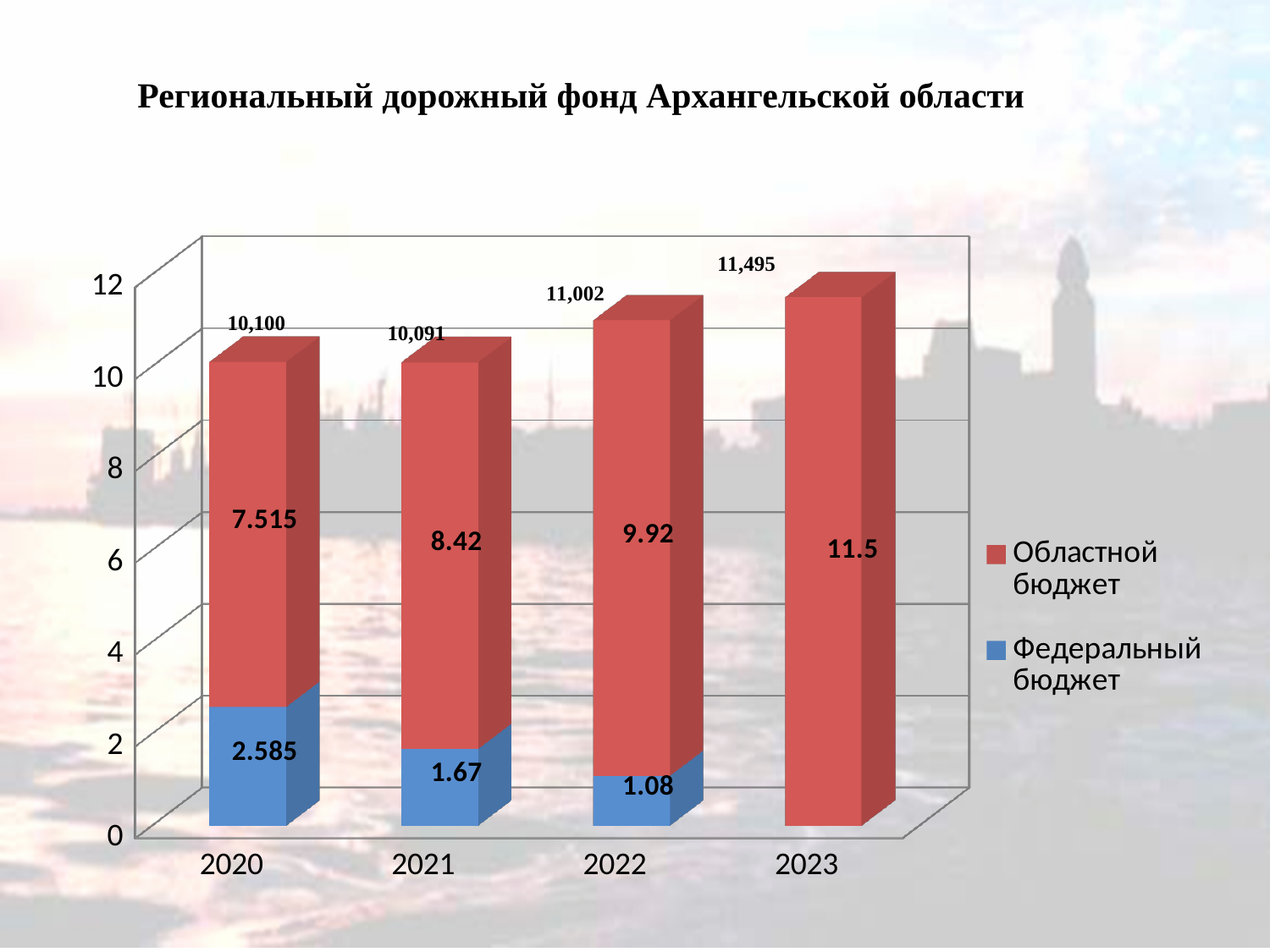
What is the value of Федеральный бюджет for 2020? 2.585 What is the title of the chart? Региональный дорожный фонд Архангельской области How many series does the legend list? 2 Which year has the highest value for Областной бюджет? 2023 What kind of chart is shown on the slide? Stacked bar chart What is the difference between the Областной бюджет values for 2022 and 2021? 1.5 Does the value of Федеральный бюджет rise or fall from 2020 to 2022? Fall What is the value of Областной бюджет for 2023? 11.5 Which year has the lowest value for Федеральный бюджет among the years where it is shown? 2022 What total is printed above the bar for 2022? 11,002 What is the value of Областной бюджет for 2021? 8.42 How many years are shown on the x axis? 4